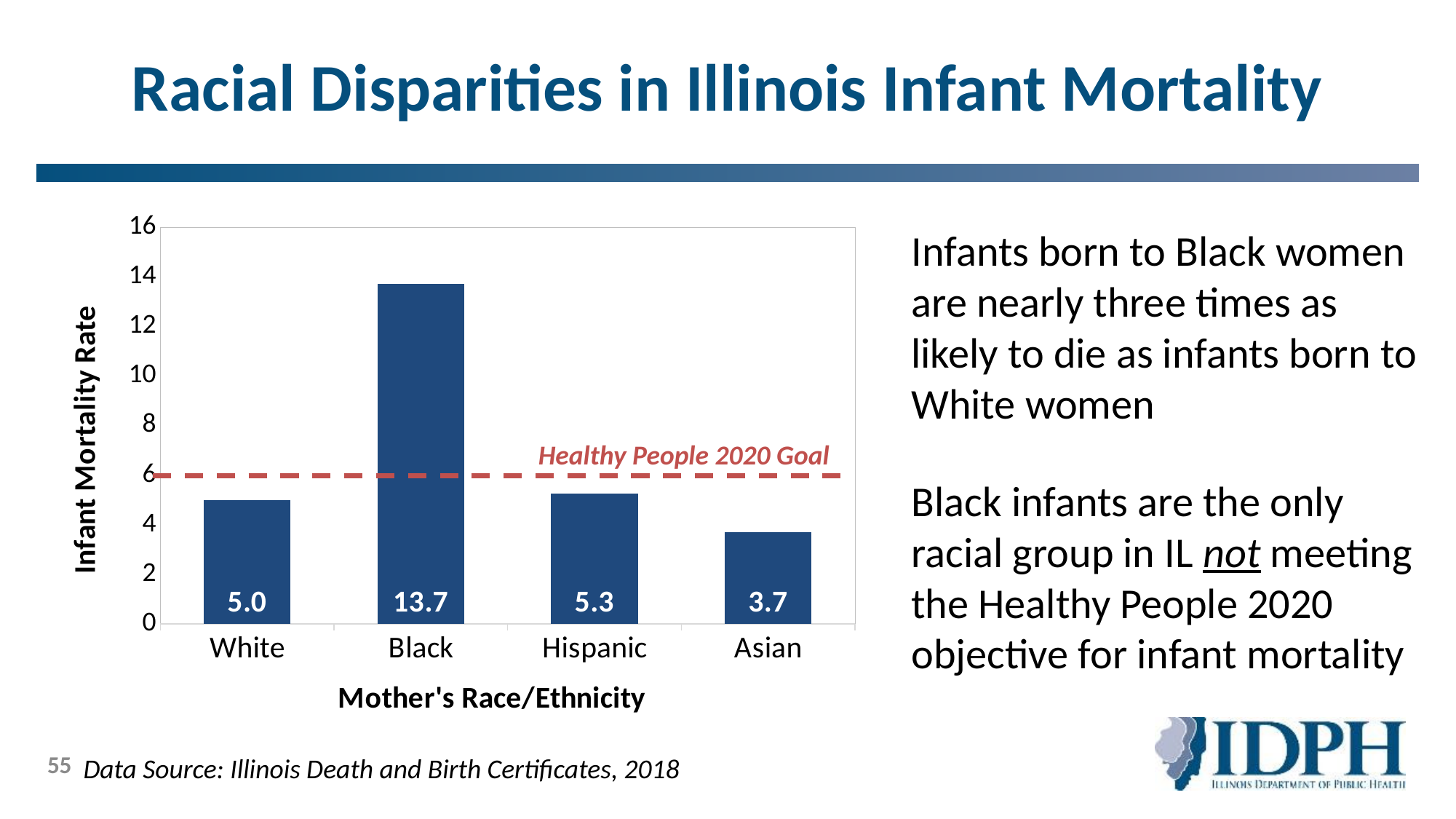
What is the infant mortality rate for infants born to White mothers? 5.0 How many mother's race/ethnicity categories are shown in the chart? 4 What is the difference between the infant mortality rates for Black and White mothers? 8.7 Is the infant mortality rate for Black mothers greater or less than 12? greater What does the red dashed line on the chart represent? Healthy People 2020 Goal What is the infant mortality rate for infants born to Hispanic mothers? 5.3 What is the infant mortality rate for infants born to Black mothers? 13.7 Which mother's race/ethnicity group has the lowest infant mortality rate? Asian Which group has a higher infant mortality rate, Hispanic or Asian? Hispanic What type of chart is used to show infant mortality rates by mother's race/ethnicity? Bar chart Which mother's race/ethnicity group has the highest infant mortality rate? Black What is the infant mortality rate for infants born to Asian mothers? 3.7